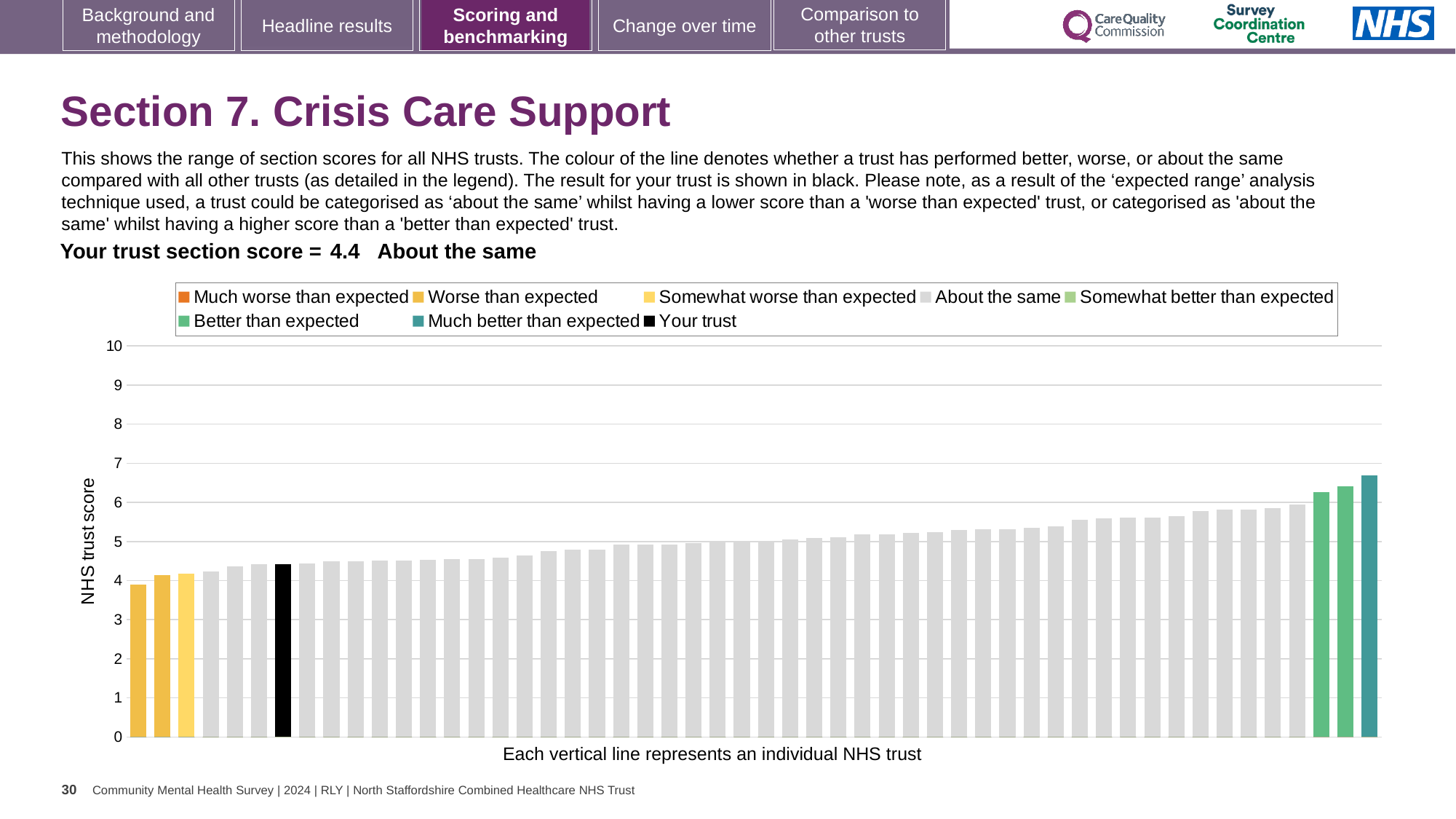
What is the section score for your trust shown on the slide? 4.4 Which category is your trust placed in for this section? About the same What colour is the bar representing your trust? Black What kind of chart is shown on the slide? Bar chart Which is larger, the value for your trust (black bar) or the value of the rightmost bar? The rightmost bar Is the value of the tallest bar greater or less than 6? greater What is the label on the vertical axis? NHS trust score How many bars are coloured as 'Much better than expected'? 1 How many entries does the chart legend list? 8 Do the bar values rise or fall from left to right along the x axis? Rise Is the value for your trust greater or less than 5? less Is the value of the tallest bar greater or less than 7? less